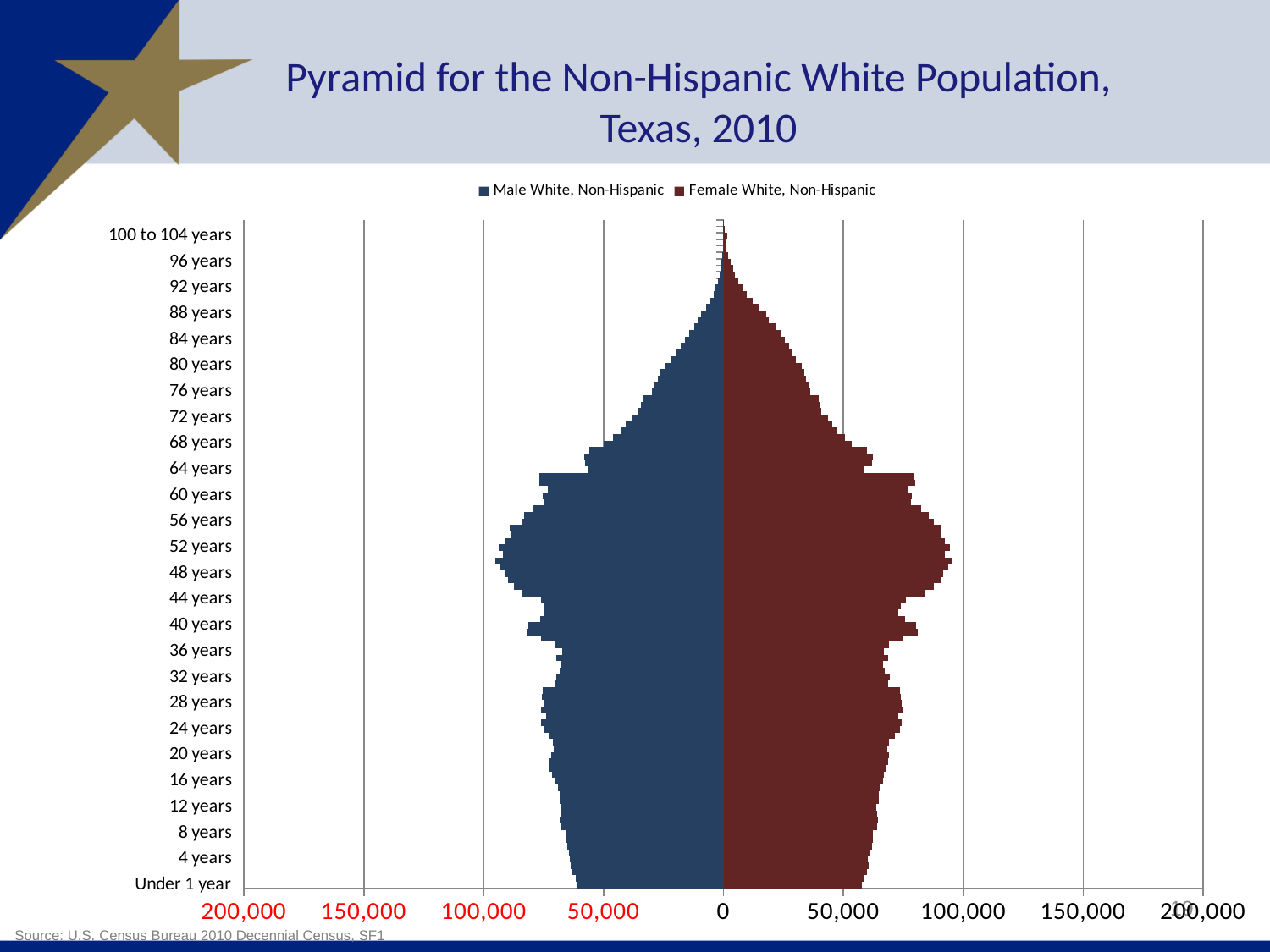
Is the value for Female White, Non-Hispanic at 52 years greater or less than 50,000? greater Which is larger, the Female White, Non-Hispanic value at 52 years or at 88 years? 52 years Is the value for Female White, Non-Hispanic at 80 years greater or less than 50,000? less Is the value for Female White, Non-Hispanic at 52 years greater or less than 100,000? less Which series is shown in dark red? Female White, Non-Hispanic What kind of chart is shown on the slide? bar chart Which is larger, the Male White, Non-Hispanic value at 96 years or at 16 years? 16 years How many series does the legend list? 2 What is the title of the chart? Pyramid for the Non-Hispanic White Population, Texas, 2010